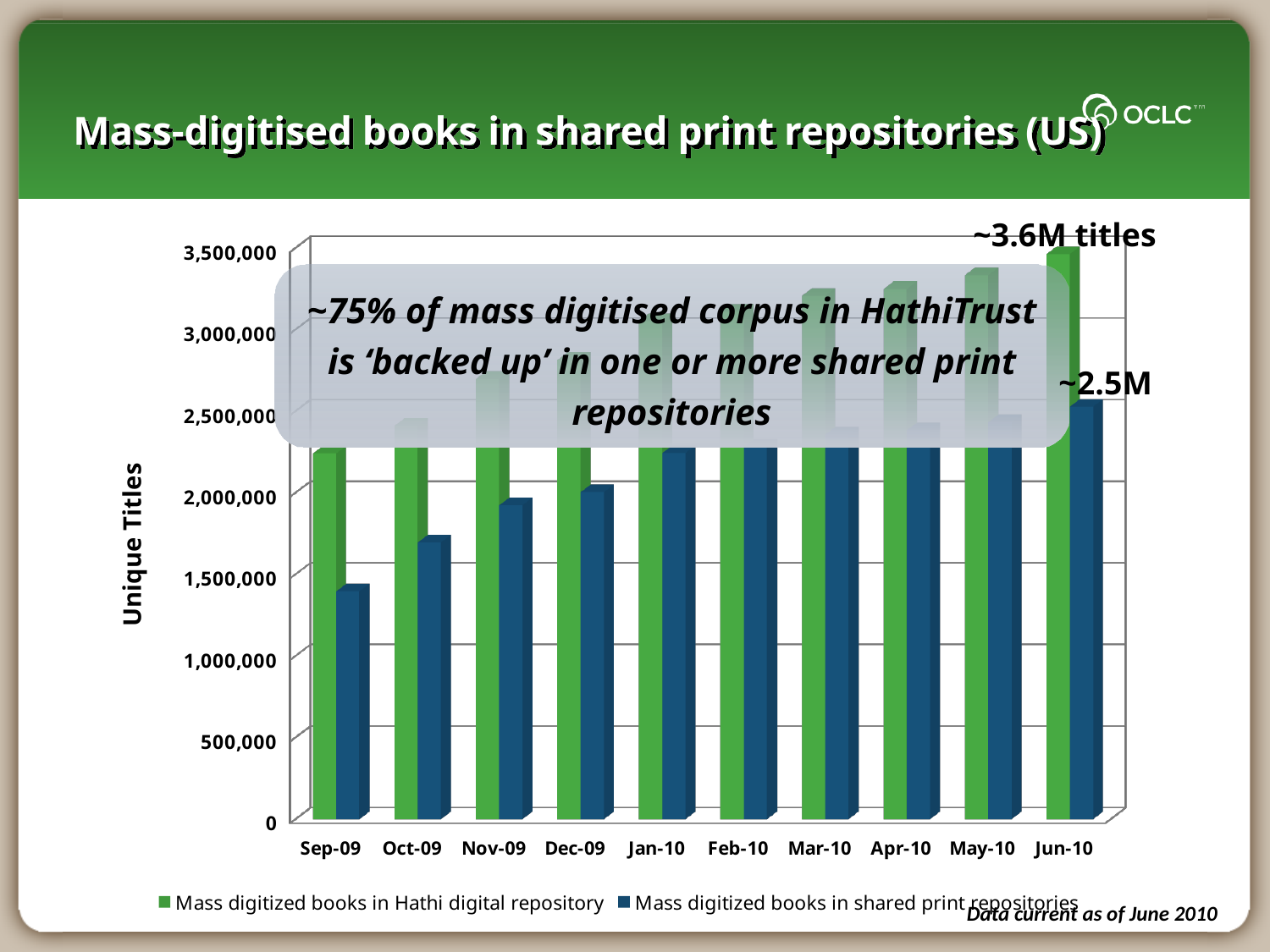
In which month is the value for mass digitized books in Hathi digital repository lowest? Sep-09 Is the value for mass digitized books in Hathi digital repository in Sep-09 greater or less than 2,000,000? greater What is the label on the chart's y axis? Unique Titles In which month is the value for mass digitized books in shared print repositories highest? Jun-10 How many series does the chart's legend list? 2 Is the value for mass digitized books in shared print repositories in Sep-09 greater or less than 1,500,000? less Is the value for mass digitized books in shared print repositories in Jan-10 greater or less than 2,000,000? greater What kind of chart is shown on the slide? bar chart How many months are shown along the x axis of the chart? 10 Do the values for mass digitized books in shared print repositories rise or fall from Sep-09 to Jun-10? rise In Sep-09, which is larger: mass digitized books in Hathi digital repository or mass digitized books in shared print repositories? Mass digitized books in Hathi digital repository